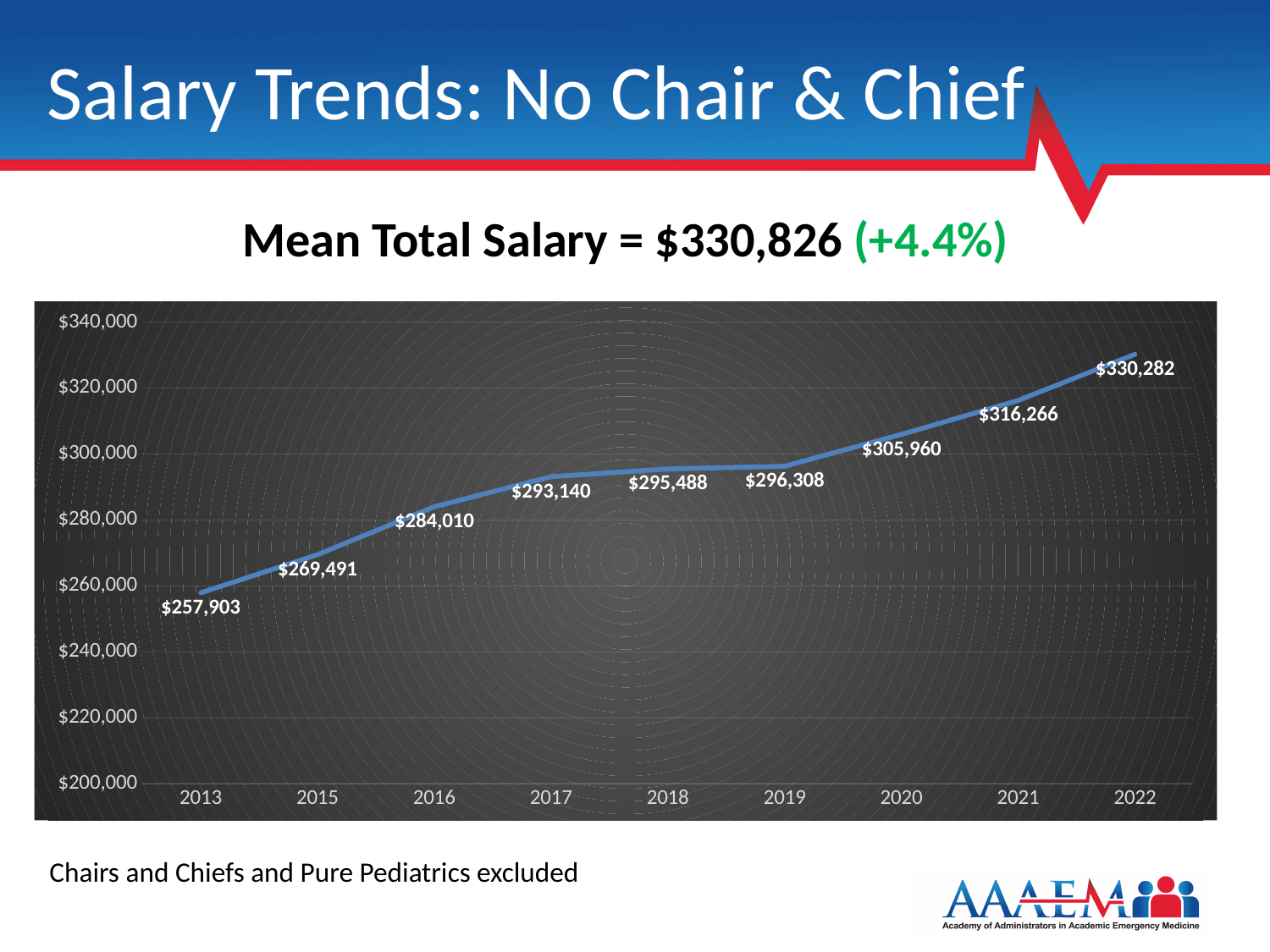
Do the plotted values rise or fall from 2013 to 2022? rise Is the value for 2020 greater or less than $300,000? greater What is the difference between the 2022 value and the 2013 value? $72,379 What is the value plotted for 2018? $295,488 Which is larger, the value for 2016 or the value for 2015? 2016 What is the value plotted for 2022? $330,282 What is the difference between the 2021 value and the 2020 value? $10,306 What is the value plotted for 2013? $257,903 Which year has the highest plotted value? 2022 How many years are plotted on the chart? 9 What kind of chart is shown on the slide? line chart Which year has the lowest plotted value? 2013